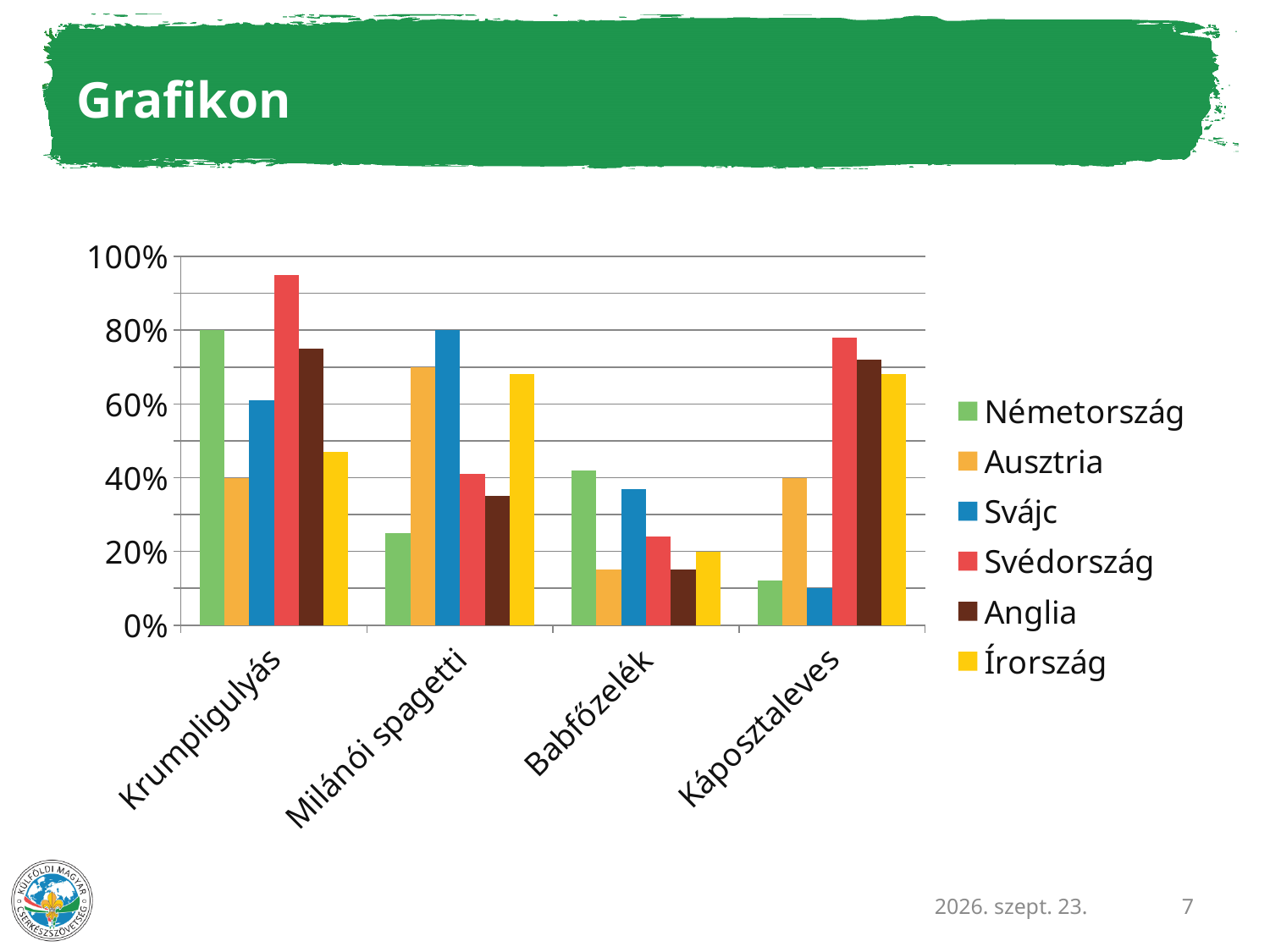
What is the value for Svájc in the Milánói spagetti category? 80% Which country has the lowest value in the Káposztaleves category? Svájc Is the value for Svédország in the Krumpligulyás category greater or less than 80%? greater What kind of chart is shown on the slide? bar chart How many series does the legend list? 6 Which country has the highest value in the Milánói spagetti category? Svájc In the Babfőzelék category, which is larger: the value for Németország or the value for Svájc? Németország How many categories are shown on the x axis? 4 Which country has the highest value in the Krumpligulyás category? Svédország What colour represents Írország in the legend? yellow Is the value for Svájc in the Káposztaleves category greater or less than 20%? less What is the value for Németország in the Krumpligulyás category? 80%